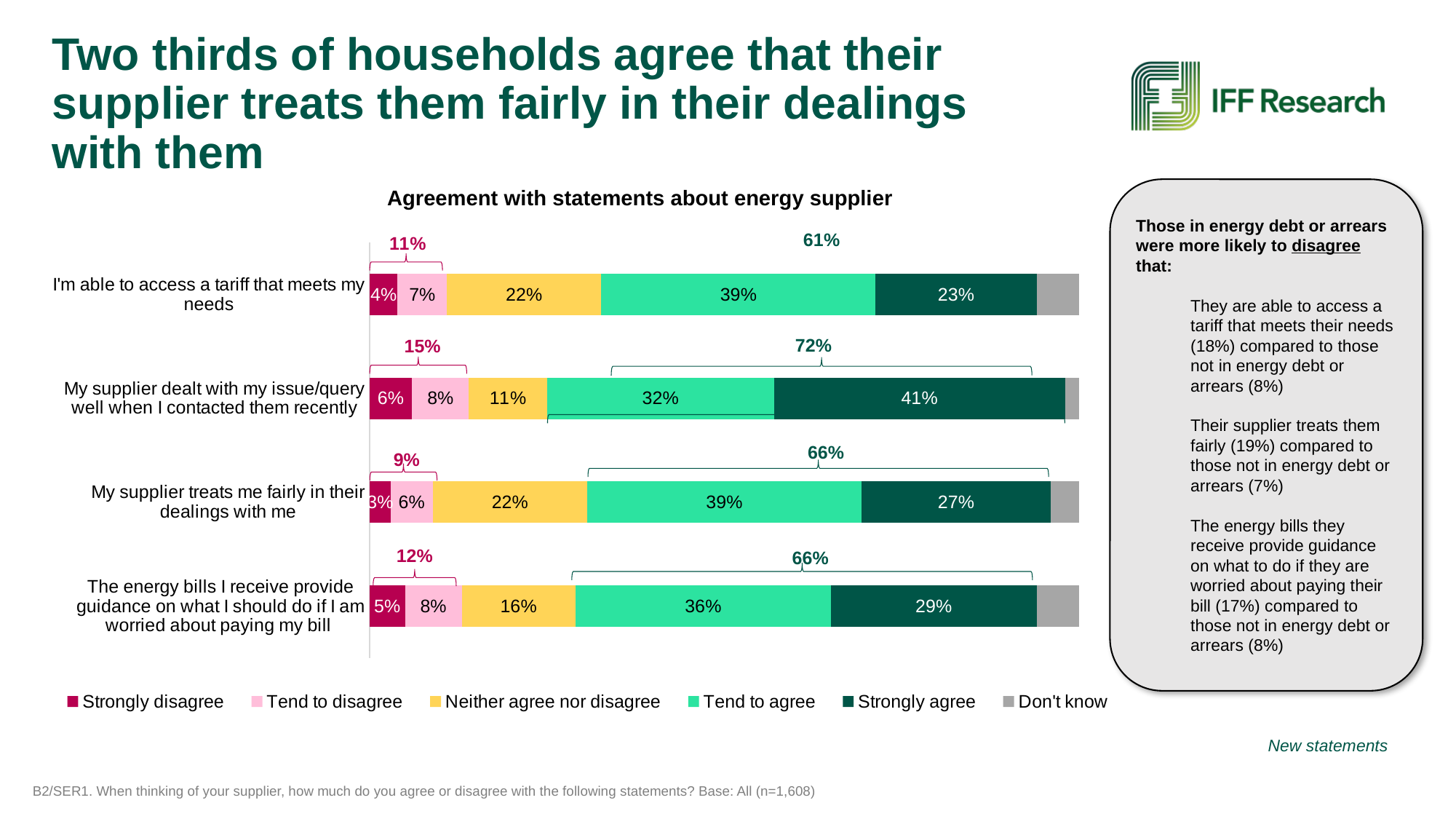
Which statement has the lowest 'Strongly disagree' percentage? My supplier treats me fairly in their dealings with me Which statement has the highest 'Strongly agree' percentage? My supplier dealt with my issue/query well when I contacted them recently What is the combined agreement percentage shown for 'My supplier dealt with my issue/query well when I contacted them recently'? 72% How many series does the legend list? 6 What is the difference between the 'Tend to agree' percentage for 'I'm able to access a tariff that meets my needs' and for 'My supplier dealt with my issue/query well when I contacted them recently'? 7 percentage points What percentage neither agree nor disagree that the energy bills they receive provide guidance on what to do if worried about paying their bill? 16% What is the combined disagreement percentage shown for 'My supplier treats me fairly in their dealings with me'? 9% What percentage strongly agree that their supplier dealt with their issue/query well when they contacted them recently? 41% How many statements are shown in the chart? 4 What kind of chart is shown on the slide? Stacked bar chart Which has a larger 'Strongly agree' percentage: 'I'm able to access a tariff that meets my needs' or 'The energy bills I receive provide guidance on what I should do if I am worried about paying my bill'? The energy bills I receive provide guidance on what I should do if I am worried about paying my bill What is the title of the chart? Agreement with statements about energy supplier